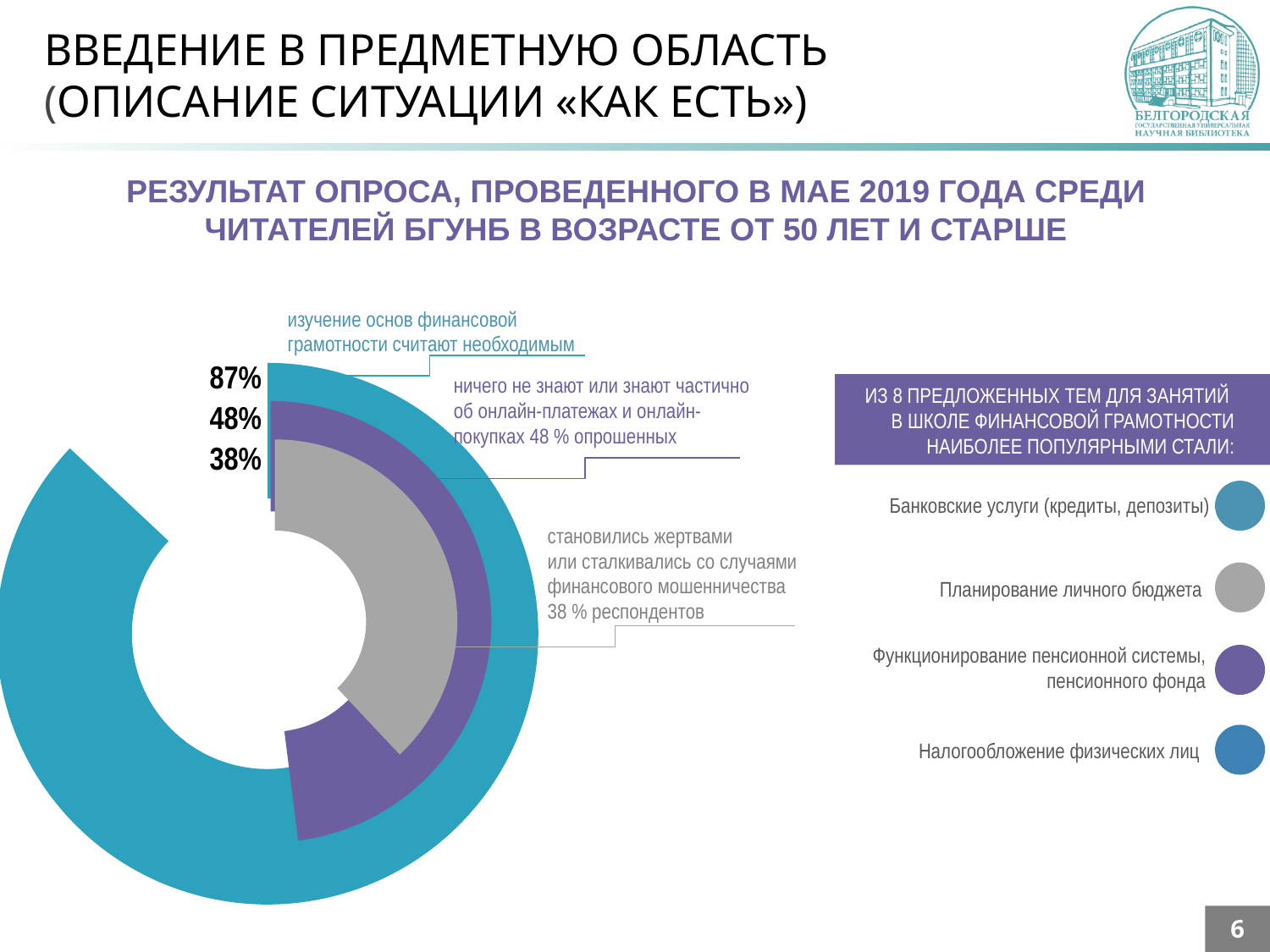
Что больше: доля не знающих об онлайн-платежах или доля столкнувшихся с финансовым мошенничеством? доля не знающих об онлайн-платежах (48%) На сколько процентных пунктов доля считающих необходимым изучение основ финансовой грамотности больше доли столкнувшихся с финансовым мошенничеством? 49 Какой процент опрошенных ничего не знает или знает частично об онлайн-платежах и онлайн-покупках? 48% Сколько показателей отображено на диаграмме? 3 Каким цветом показан показатель 38%? серым Каким цветом показан показатель 87%? синим (голубым) Какой показатель на диаграмме самый большой? изучение основ финансовой грамотности считают необходимым (87%) Какой процент респондентов становились жертвами или сталкивались со случаями финансового мошенничества? 38% На сколько процентных пунктов доля не знающих об онлайн-платежах больше доли столкнувшихся с финансовым мошенничеством? 10 Какой процент опрошенных считает необходимым изучение основ финансовой грамотности? 87% Какой показатель на диаграмме самый маленький? становились жертвами или сталкивались со случаями финансового мошенничества (38%) Какого типа диаграмма на слайде? кольцевая диаграмма